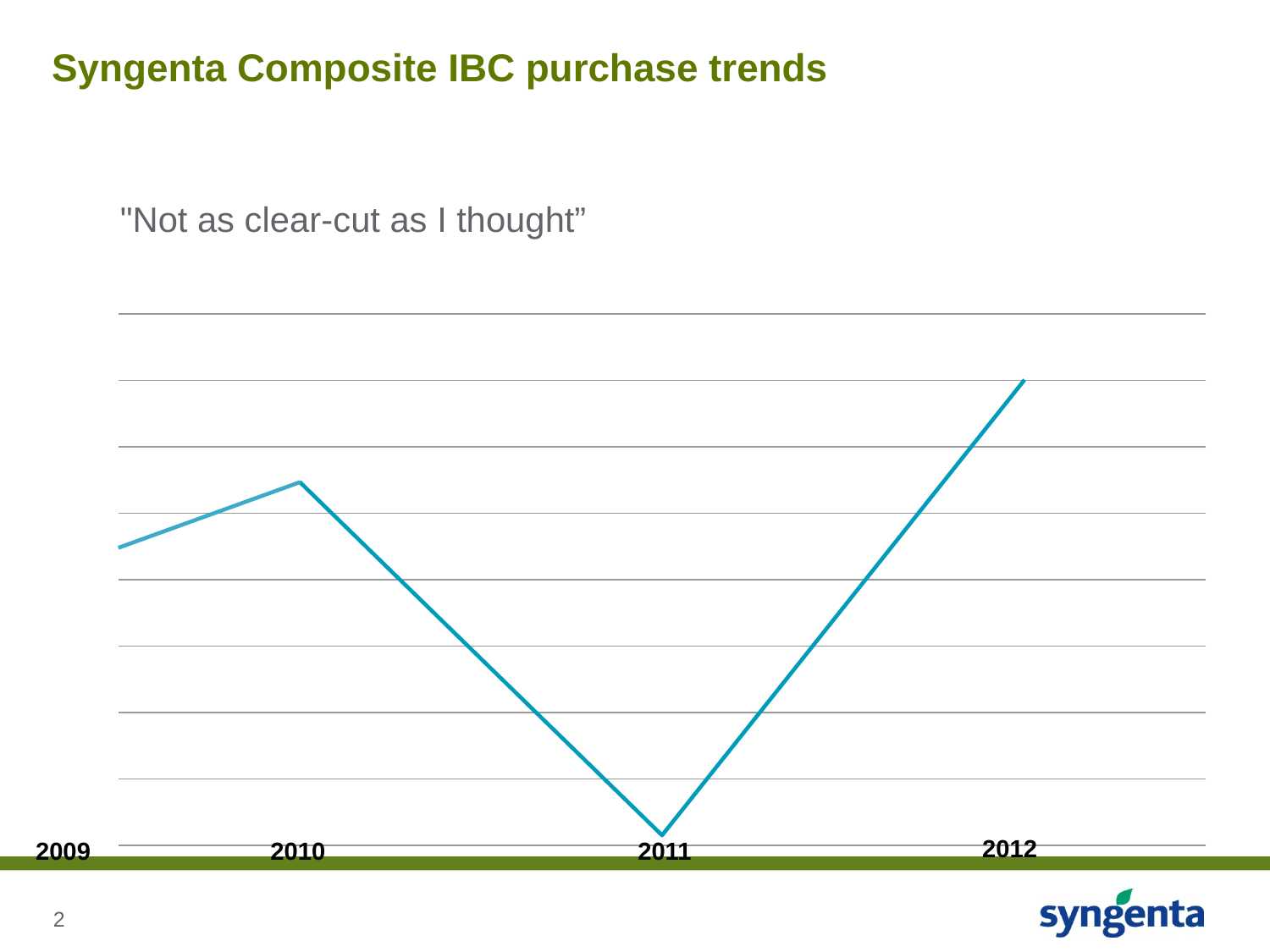
Is the value for 2012 higher or lower than the value for 2010? higher Is the value for 2010 higher or lower than the value for 2009? higher Does the line rise or fall from 2010 to 2011? fall Is the value for 2011 higher or lower than the value for 2010? lower Which year has the highest value on the chart? 2012 What is the first year shown on the x axis of the chart? 2009 How many years are plotted along the x axis of the chart? 4 Does the line rise or fall from 2011 to 2012? rise Which year has the lowest value on the chart? 2011 What kind of chart is shown on the slide? line chart Does the line rise or fall from 2009 to 2010? rise What is the title of the slide containing the chart? Syngenta Composite IBC purchase trends